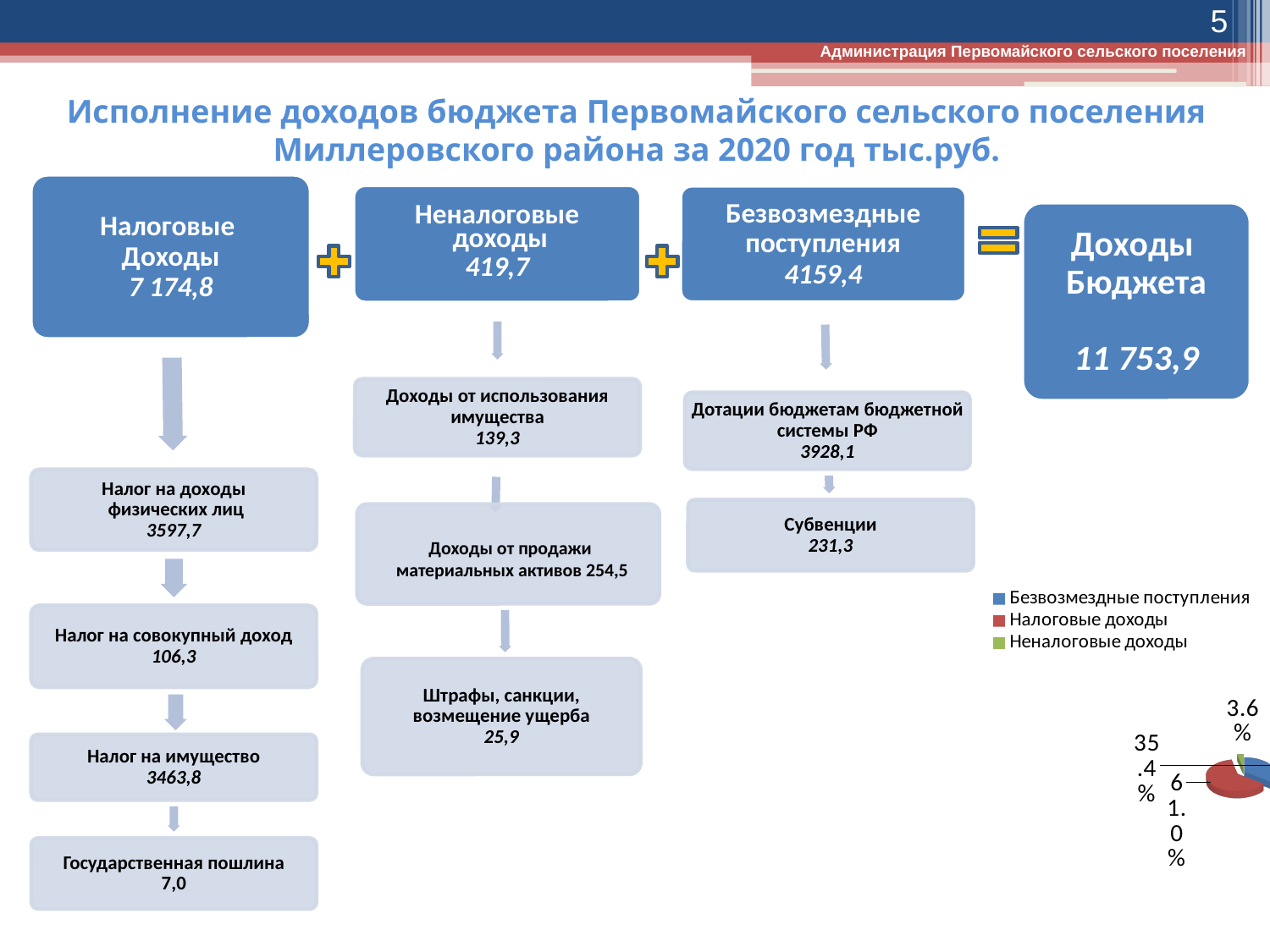
What colour is used for Налоговые доходы in the pie chart legend? red How many entries does the legend of the pie chart list? 3 What share of the pie chart is labelled for Налоговые доходы? 61.0% What kind of chart is shown in the bottom-right corner of the slide? pie chart What share of the pie chart is labelled for Безвозмездные поступления? 35.4% Which category has the smallest slice in the pie chart? Неналоговые доходы In the pie chart, which is larger: the slice for Налоговые доходы or the slice for Безвозмездные поступления? Налоговые доходы What share of the pie chart is labelled for Неналоговые доходы? 3.6% Which legend entry of the pie chart is shown in green? Неналоговые доходы Which category has the largest slice in the pie chart? Налоговые доходы In the pie chart, what is the difference in percentage points between the Налоговые доходы slice and the Безвозмездные поступления slice? 25.6 How many slices does the pie chart have? 3